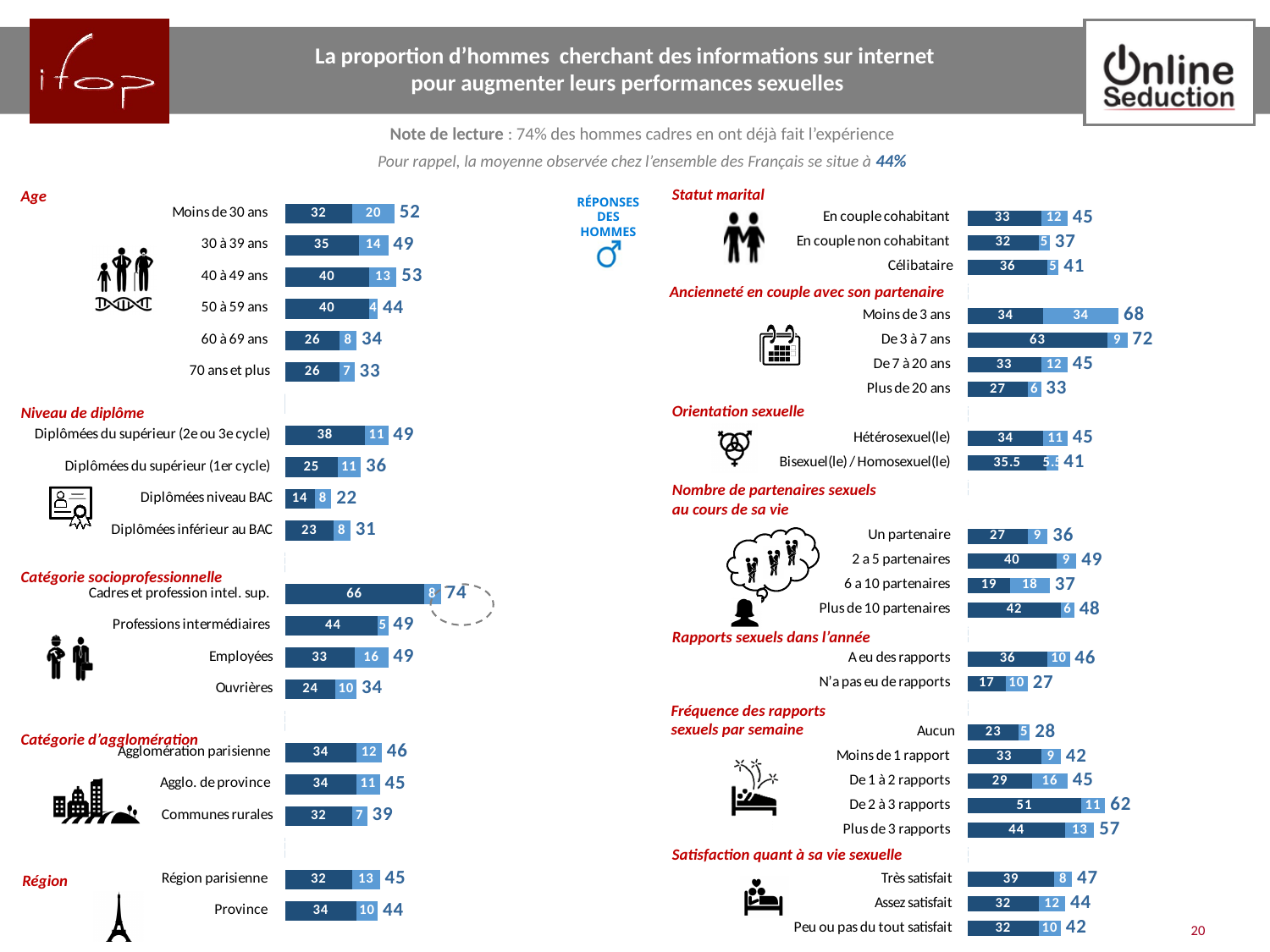
According to the note de lecture, what is the average observed for all French people? 44% In the 'Satisfaction quant à sa vie sexuelle' chart, what is the light blue segment value for 'Assez satisfait'? 12 In the 'Rapports sexuels dans l'année' chart, what is the total for 'N'a pas eu de rapports'? 27 In the 'Age' chart, what is the total value shown for 'Moins de 30 ans'? 52 In the 'Age' chart, what is the difference between the totals for '40 à 49 ans' and '70 ans et plus'? 20 What type of chart is used for the 'Statut marital' data? Stacked bar chart How many categories are shown in the 'Nombre de partenaires sexuels au cours de sa vie' chart? 4 In the 'Ancienneté en couple avec son partenaire' chart, what is the dark blue segment value for 'De 3 à 7 ans'? 63 In the 'Catégorie d'agglomération' chart, do the totals rise or fall from 'Agglomération parisienne' to 'Communes rurales'? Fall In the 'Catégorie socioprofessionnelle' chart, which category has the highest total? Cadres et profession intel. sup. In the 'Niveau de diplôme' chart, which category has the lowest total? Diplômées niveau BAC In the 'Fréquence des rapports sexuels par semaine' chart, which is larger: the total for 'De 2 à 3 rapports' or 'Plus de 3 rapports'? De 2 à 3 rapports